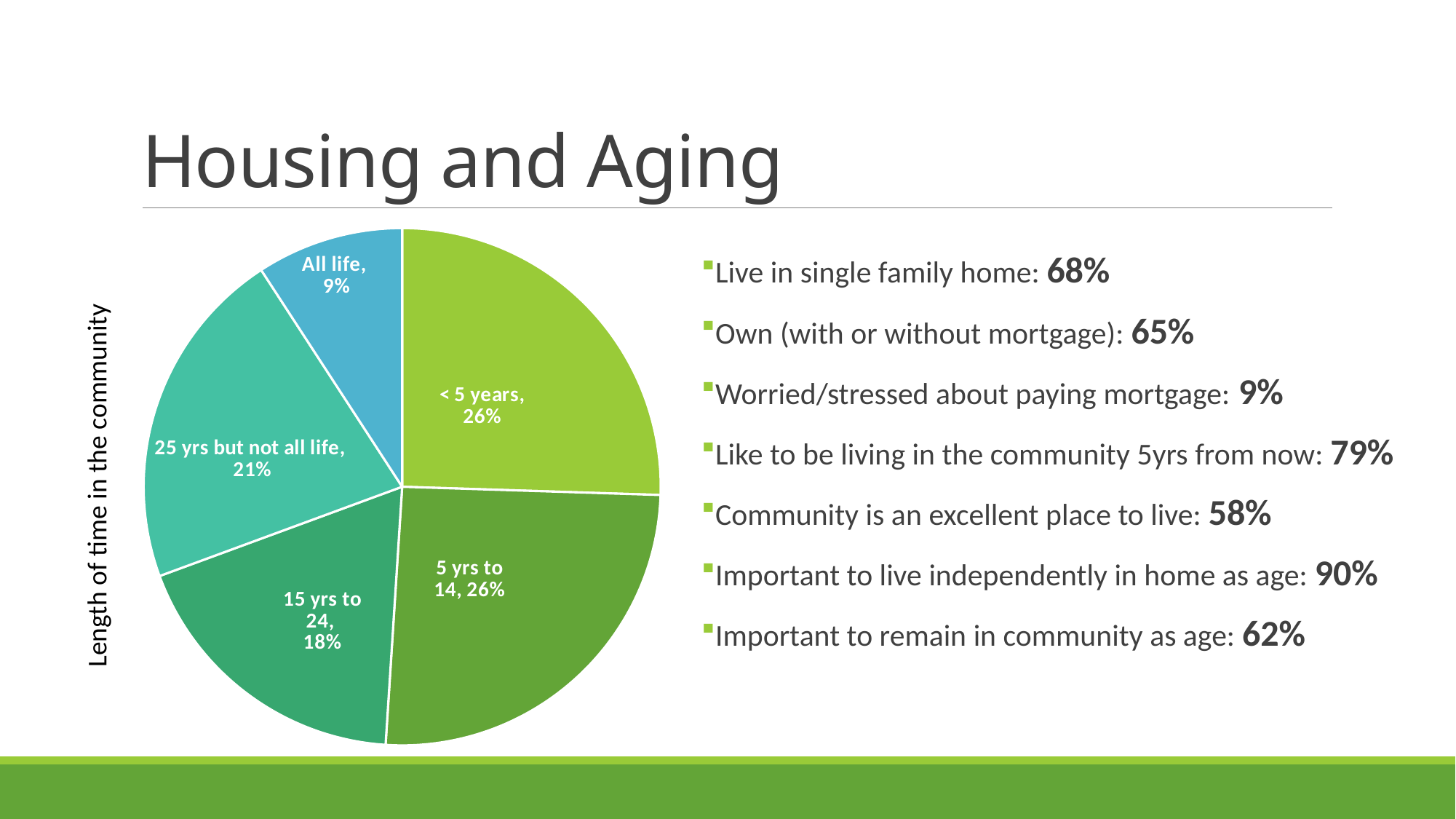
What share of the pie is the "All life" slice? 9% What share of the pie is the "25 yrs but not all life" slice? 21% What kind of chart is shown on the slide? pie chart Which is larger, the "25 yrs but not all life" slice or the "15 yrs to 24" slice? 25 yrs but not all life What is the difference in percentage points between the "25 yrs but not all life" slice and the "15 yrs to 24" slice? 3 What share of the pie is the "< 5 years" slice? 26% Which slice of the pie is the smallest? All life What is the title written vertically beside the pie chart? Length of time in the community How many slices does the pie chart have? 5 What is the difference in percentage points between the "< 5 years" slice and the "All life" slice? 17